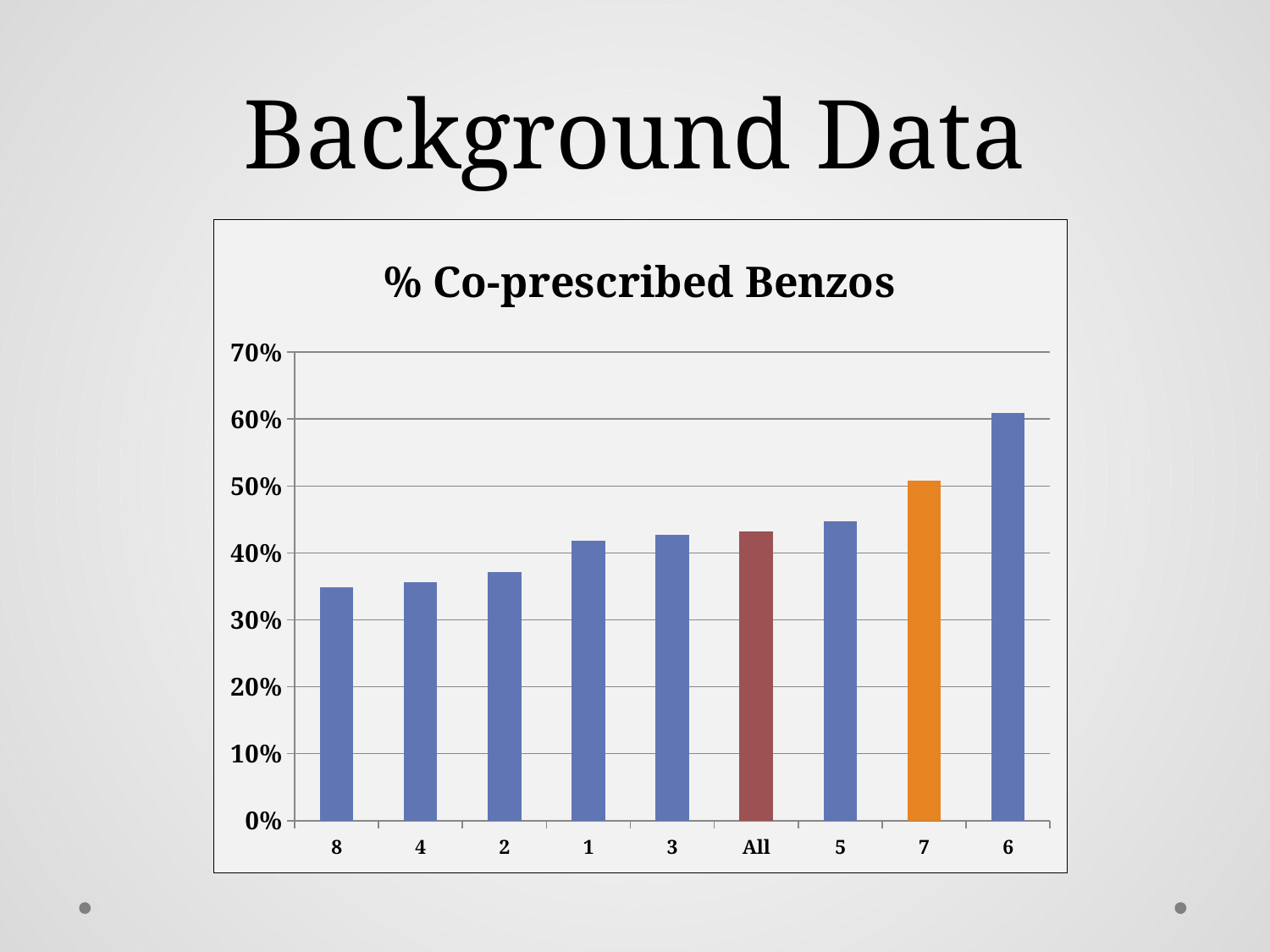
Which has the larger value, category 7 or category 5? 7 How many bars are plotted in the chart? 9 Which category has the lowest value? 8 Is the value for category 6 greater or less than 60%? greater Which category has the highest value? 6 Is the value for category 7 greater or less than 50%? greater Which bar is coloured orange? 7 Is the value for 'All' greater or less than 40%? greater What kind of chart is shown on the slide? bar chart What is the title of the chart? % Co-prescribed Benzos Do the values rise or fall moving from left to right along the x axis? rise